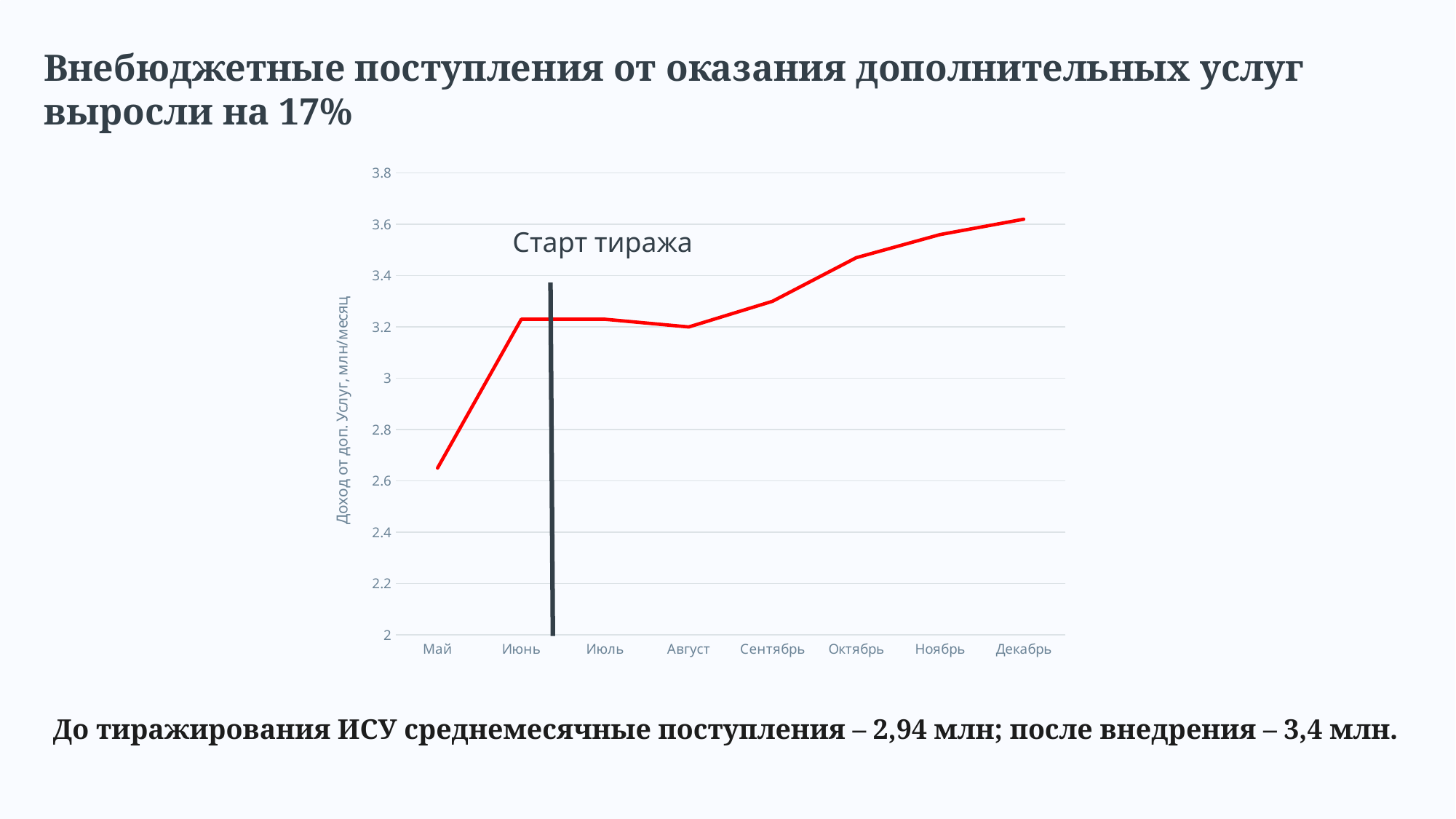
What kind of chart is shown on the slide? line chart Is the value for Май greater or less than 2.8? less What text labels the vertical line drawn between Июнь and Июль? Старт тиража How many months are plotted along the x axis? 8 Which month has the lowest value on the chart? Май Do the values generally rise or fall from Май to Декабрь? rise What is the label of the y axis? Доход от доп. Услуг, млн/месяц Which is larger, the value for Октябрь or the value for Август? Октябрь Is the value for Август greater or less than 3.4? less Is the value for Декабрь greater or less than 3.4? greater Which month has the highest value on the chart? Декабрь